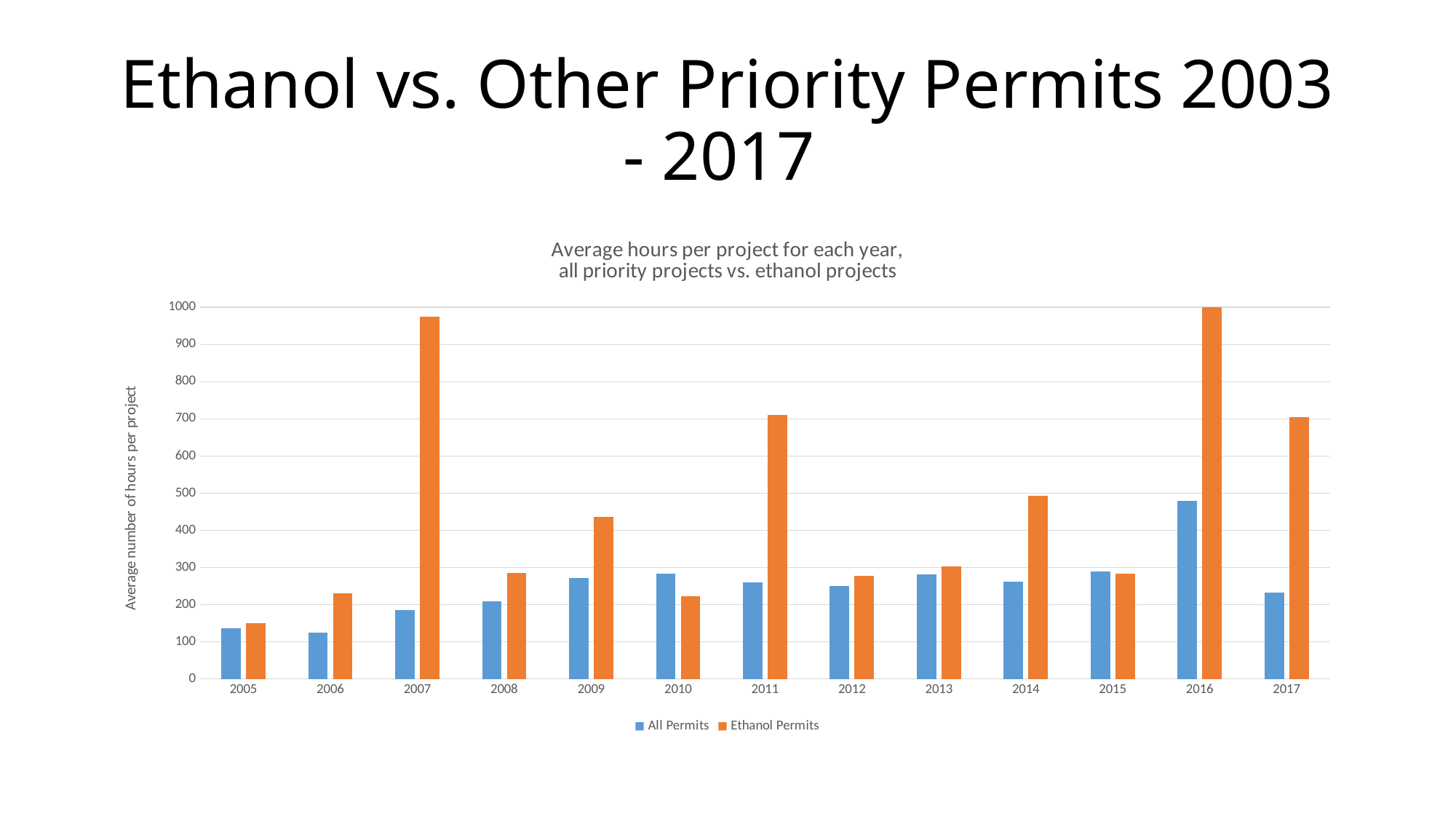
Is the value for Ethanol Permits in 2017 greater or less than 600? greater How many years are shown on the x axis? 13 How many series does the legend list? 2 Is the value for Ethanol Permits in 2009 greater or less than 400? greater Which year has the highest value for All Permits? 2016 What kind of chart is shown on the slide? Bar chart Is the value for All Permits in 2016 greater or less than 500? less In 2010, which is larger: All Permits or Ethanol Permits? All Permits What is the label on the vertical axis? Average number of hours per project Which year has the lowest value for Ethanol Permits? 2005 In 2011, which is larger: All Permits or Ethanol Permits? Ethanol Permits